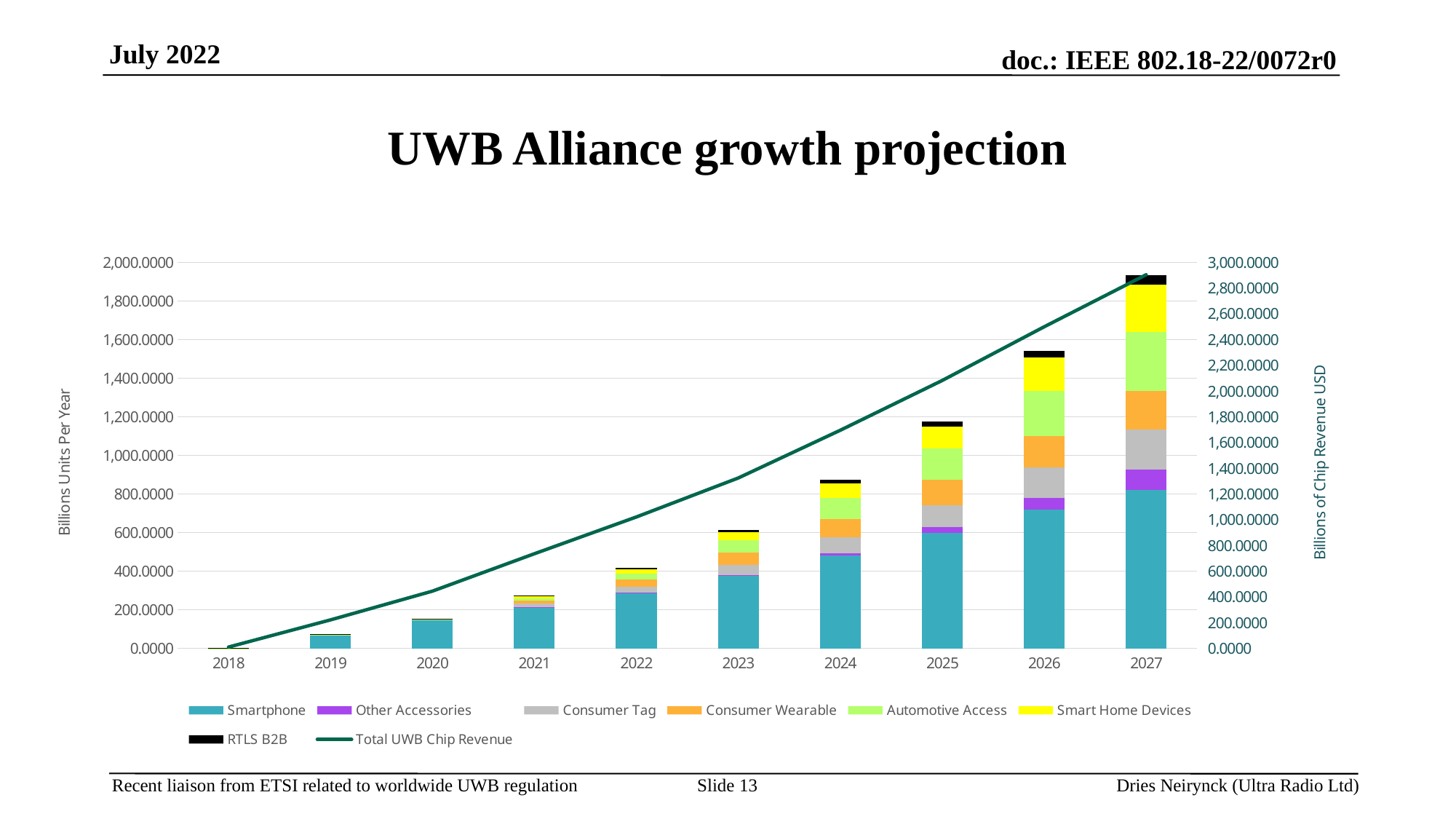
How many series does the legend list? 8 How many years are shown along the x axis? 10 Which year has the tallest stacked bar? 2027 Which year has the shortest stacked bar? 2018 Do the stacked bar totals rise or fall from 2018 to 2027? Rise What is the title of the chart? UWB Alliance growth projection Is the total stacked bar value for 2027 greater or less than 1,800 billion units per year? greater Is the total stacked bar value for 2020 greater or less than 200 billion units per year? less Which year has the larger stacked bar total, 2026 or 2027? 2027 Is the total stacked bar value for 2024 greater or less than 800 billion units per year? greater What kind of chart is shown on the slide? Stacked bar chart with a line